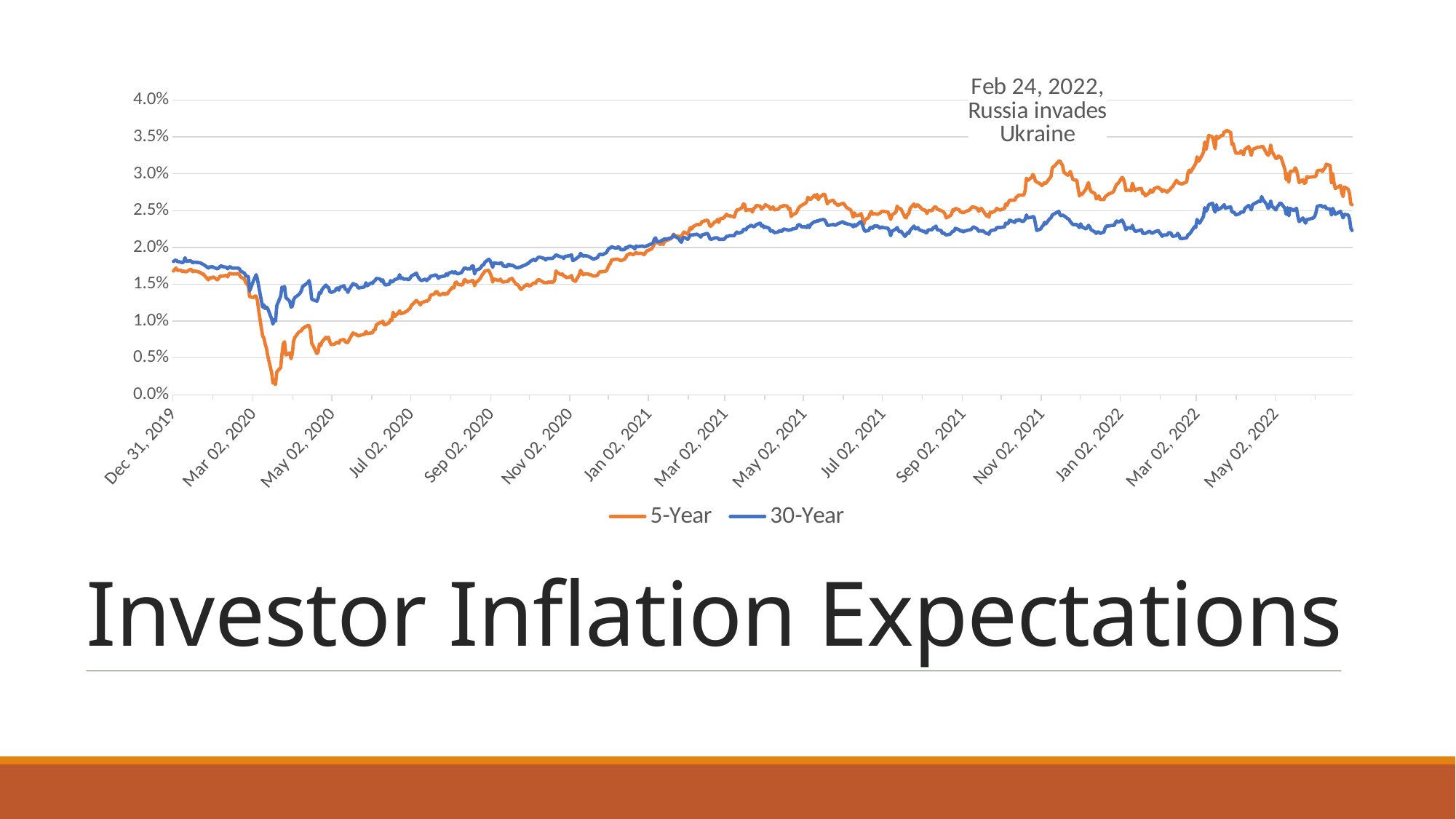
What event is annotated on the chart for Feb 24, 2022? Russia invades Ukraine Is the highest value of the 5-Year series, reached around March 2022, greater or less than 3.0%? greater Which series is higher at May 02, 2022, 5-Year or 30-Year? 5-Year What kind of chart is shown on the slide? Line chart Which series reaches the highest value anywhere on the chart? 5-Year Which series is higher at Jul 02, 2020, 5-Year or 30-Year? 30-Year Does the 5-Year series rise or fall between May 02, 2020 and Jan 02, 2021? Rise Is the highest value of the 30-Year series greater or less than 3.0%? less Is the 30-Year value at Jul 02, 2020 greater or less than 1.0%? greater What are the two series named in the legend? 5-Year and 30-Year How many series does the legend list? 2